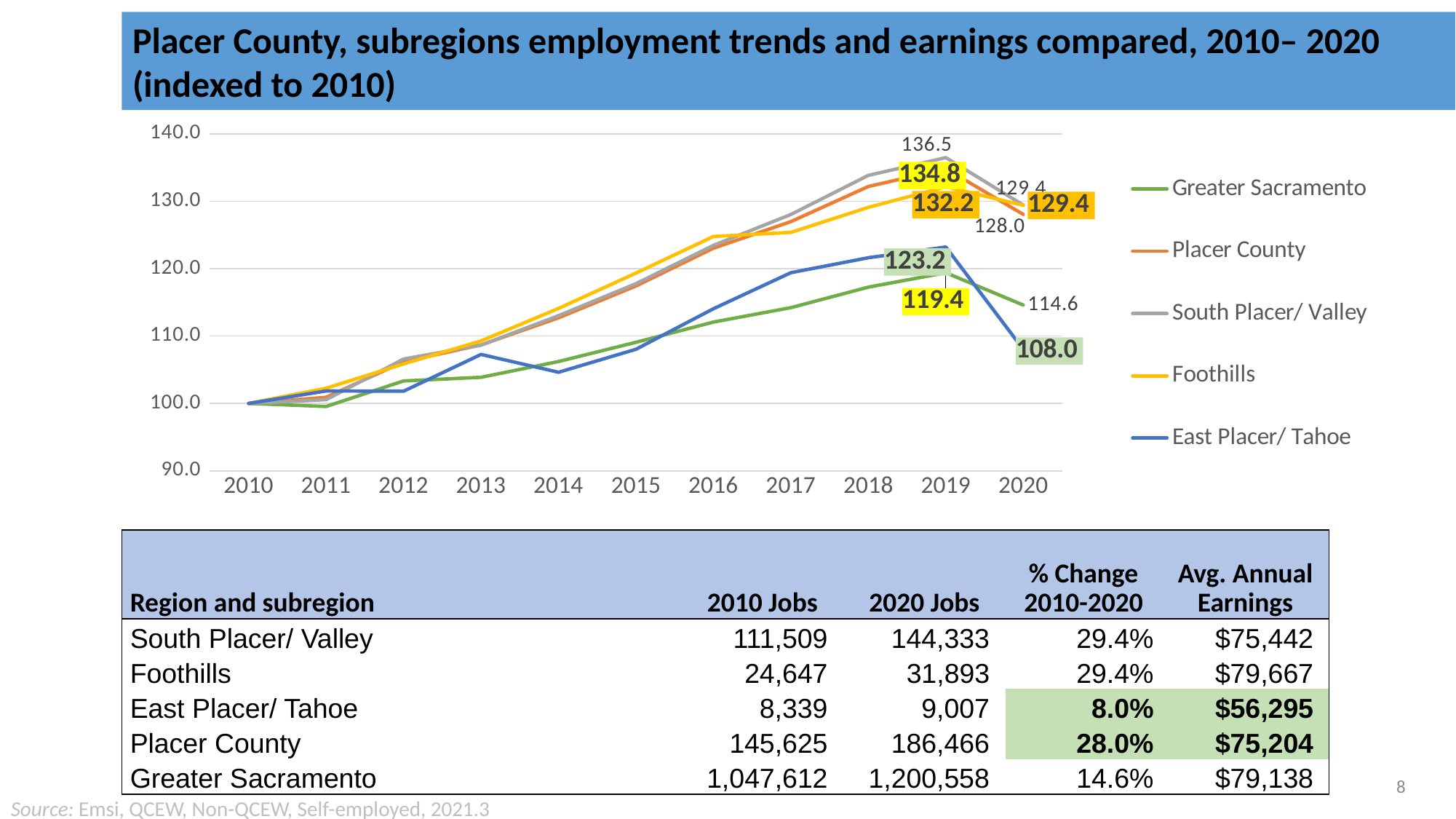
What is the indexed value for South Placer/ Valley in 2019? 136.5 Does the Greater Sacramento line rise or fall from 2019 to 2020? fall What is the indexed value for Placer County in 2020? 128.0 Which series has the lowest indexed value in 2020? East Placer/ Tahoe Which series has the highest indexed value in 2019? South Placer/ Valley What is the indexed value for East Placer/ Tahoe in 2020? 108.0 How many series does the chart legend list? 5 Which is larger in 2020, the indexed value for Greater Sacramento or for Placer County? Placer County What kind of chart is shown on the slide? line chart How many years are shown on the x axis of the chart? 11 Is the indexed value for Foothills in 2016 greater or less than 120.0? greater What is the difference between the 2019 and 2020 indexed values for East Placer/ Tahoe? 15.2